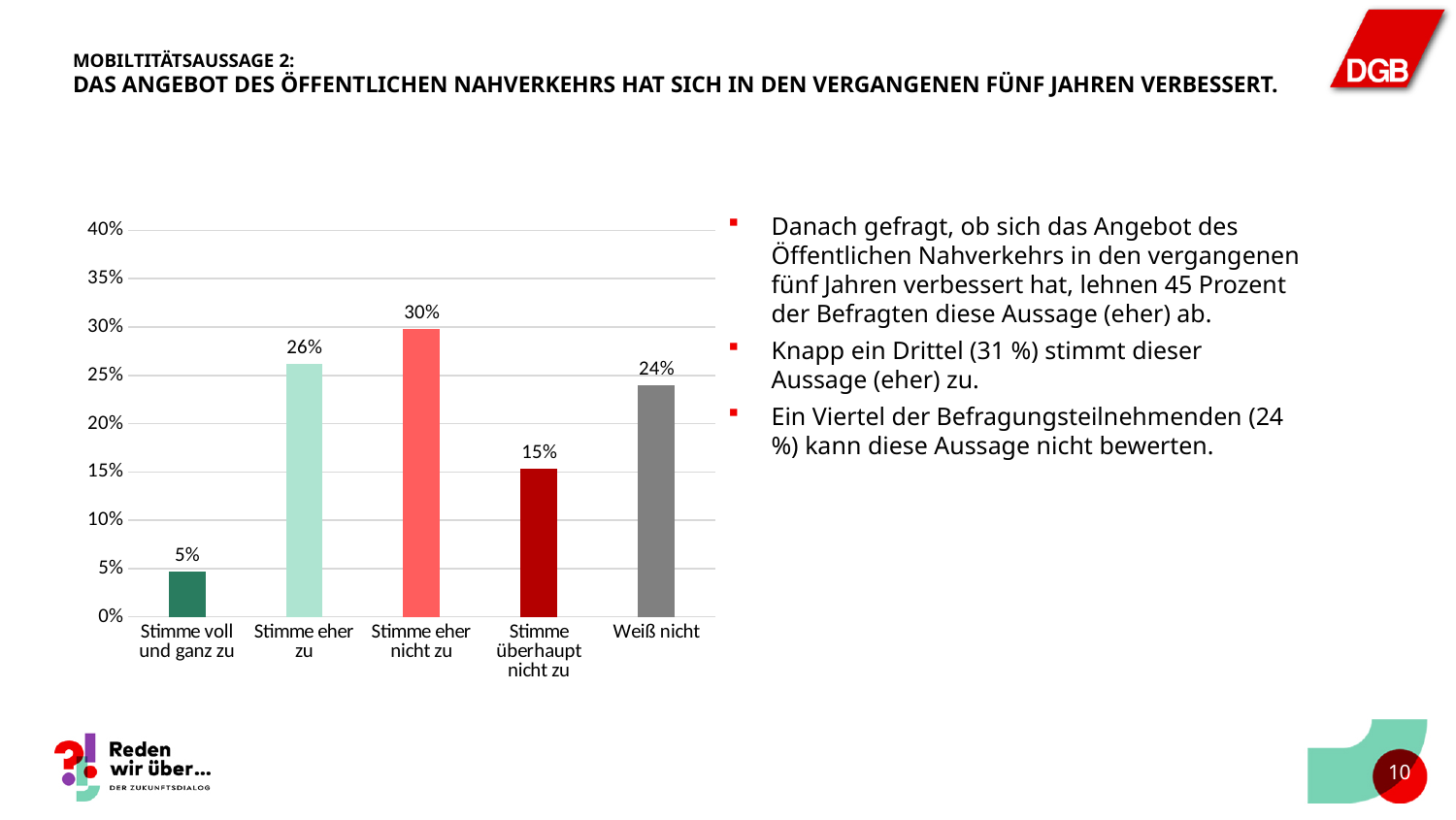
Which is larger, "Weiß nicht" or "Stimme überhaupt nicht zu"? Weiß nicht Which category has the lowest value? Stimme voll und ganz zu Which category has the highest value? Stimme eher nicht zu What is the value for "Stimme voll und ganz zu"? 5% What is the difference between "Stimme eher nicht zu" and "Stimme eher zu"? 4% What kind of chart is shown on the slide? Bar chart What is the value for "Weiß nicht"? 24% How many categories are shown on the x axis? 5 What is the value for "Stimme eher zu"? 26% What is the value for "Stimme überhaupt nicht zu"? 15% What is the value for "Stimme eher nicht zu"? 30% What is the combined value of "Stimme voll und ganz zu" and "Stimme eher zu"? 31%